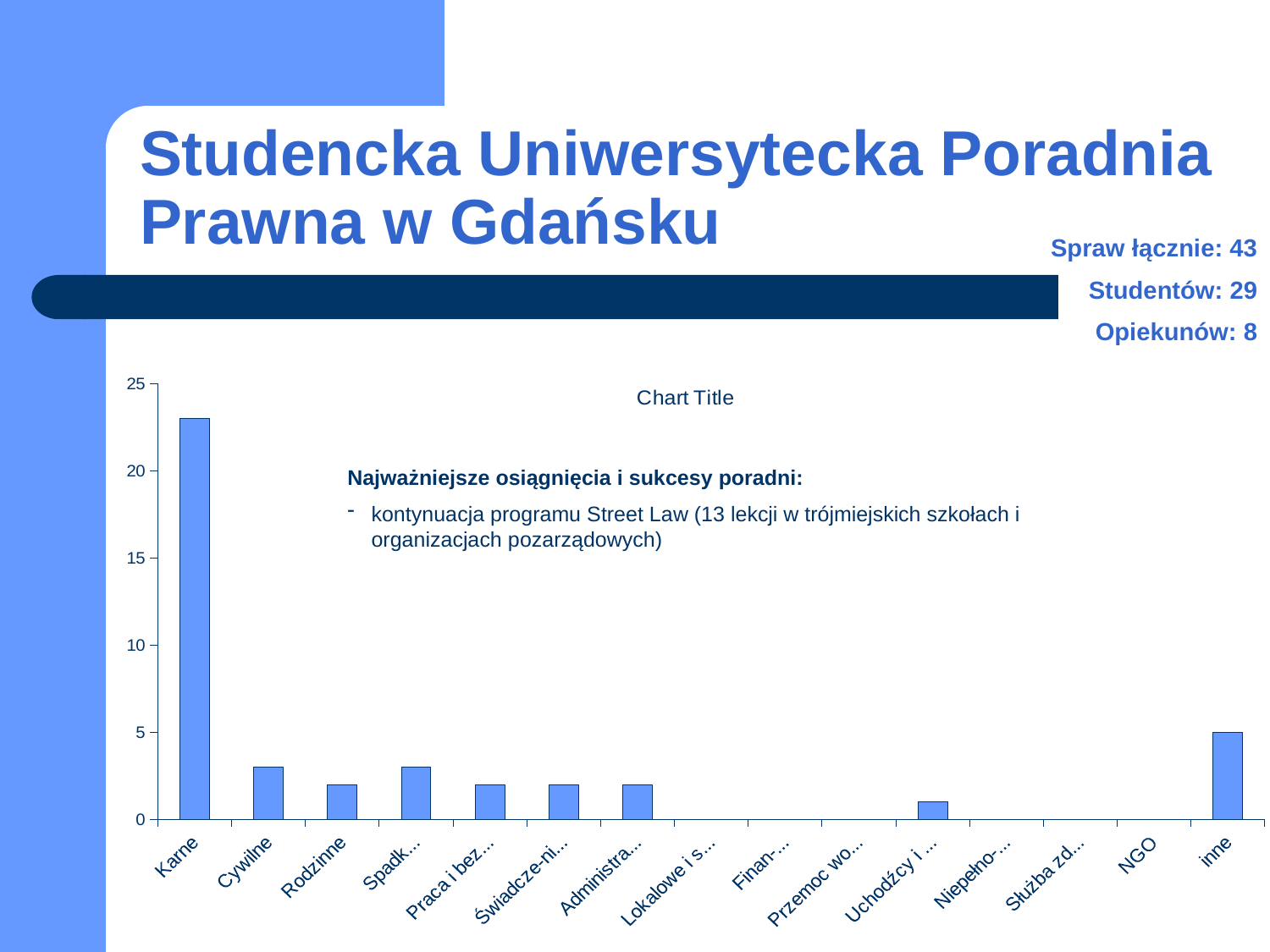
What is the highest value shown on the chart's vertical axis? 25 Which category has the highest bar in the chart? Karne Which is larger, the value for inne or the value for Cywilne? inne Is the value for Rodzinne greater or less than 5? less Which is larger, the value for Karne or the value for NGO? Karne How many categories are shown on the x axis of the chart? 15 Is the value for inne greater or less than 10? less What kind of chart is shown on the slide? bar chart Is the value for Cywilne greater or less than 5? less What is the title shown on the chart? Chart Title Which is larger, the value for Karne or the value for inne? Karne